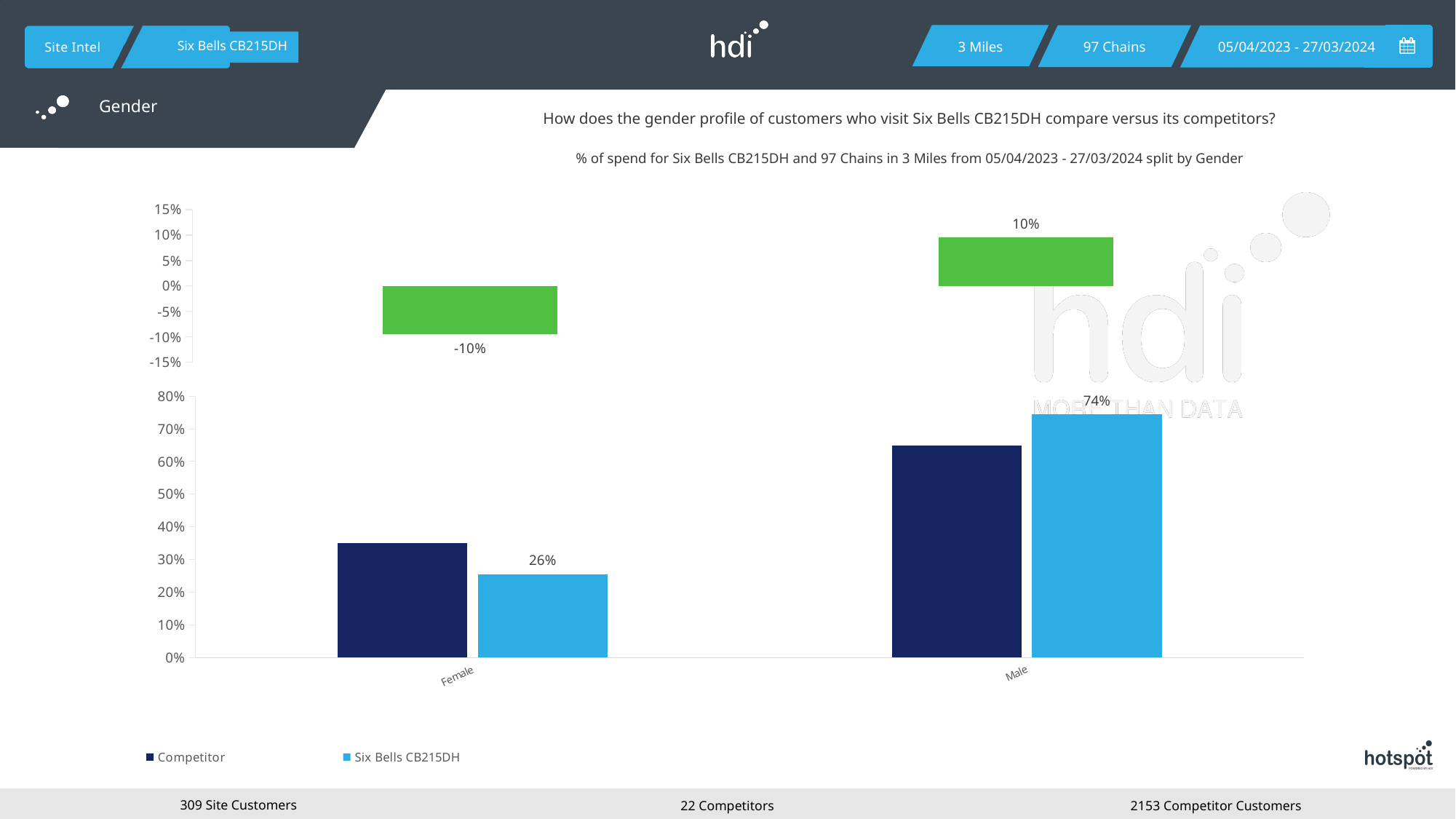
What type of chart is the bottom chart? Bar chart How many series does the legend of the bottom chart list? 2 In the bottom chart, what is the value for Six Bells CB215DH in the Female category? 26% In the bottom chart, for the Female category, which is larger: the Competitor value or the Six Bells CB215DH value? Competitor In the top chart, what is the value shown for the Male category? 10% In the bottom chart, what is the value for Six Bells CB215DH in the Male category? 74% In the bottom chart, is the Competitor value for Male greater or less than 70%? less In the bottom chart, what is the difference between the Six Bells CB215DH values for Male and Female? 48% In the bottom chart, for the Male category, which is larger: the Competitor value or the Six Bells CB215DH value? Six Bells CB215DH In the bottom chart, is the Competitor value for Female greater or less than 30%? greater In the bottom chart, which category has the higher value for Six Bells CB215DH, Female or Male? Male In the top chart, what is the value shown for the Female category? -10%